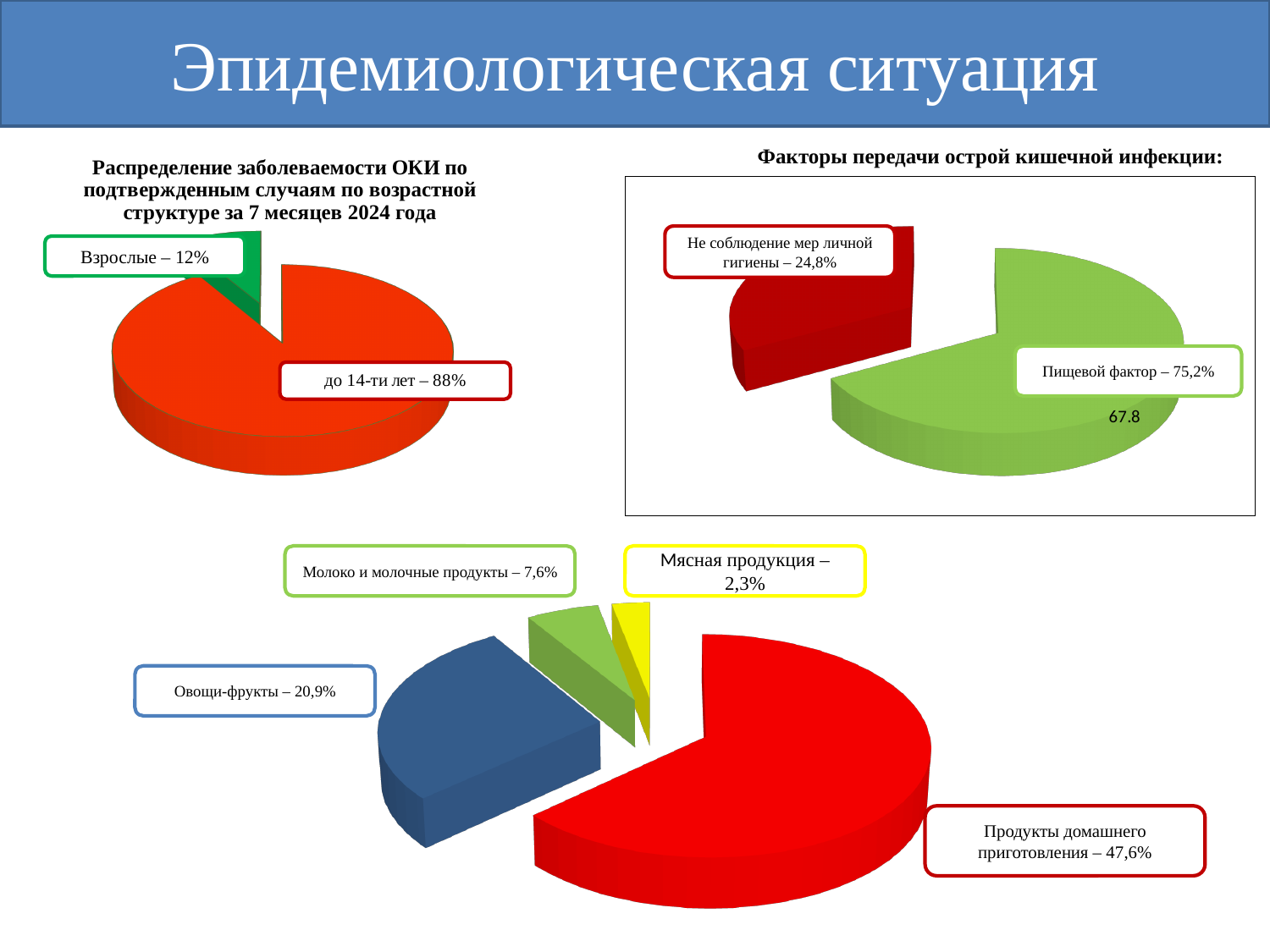
In the bottom pie chart, what share is labelled for 'Продукты домашнего приготовления'? 47,6% In the top-left pie chart on age structure, which category has the largest slice? до 14-ти лет In the top-left pie chart on age structure, what share is labelled for 'Взрослые'? 12% In the bottom pie chart, which is larger: 'Молоко и молочные продукты' or 'Мясная продукция'? Молоко и молочные продукты In the top-right chart 'Факторы передачи острой кишечной инфекции', what share is labelled for 'Не соблюдение мер личной гигиены'? 24,8% In the top-left pie chart on age structure, what share is labelled for 'до 14-ти лет'? 88% In the top-right chart 'Факторы передачи острой кишечной инфекции', what share is labelled for 'Пищевой фактор'? 75,2% In the bottom pie chart, what share is labelled for 'Мясная продукция'? 2,3% In the bottom pie chart, what share is labelled for 'Овощи-фрукты'? 20,9% In the top-right chart 'Факторы передачи острой кишечной инфекции', which factor has the smaller slice? Не соблюдение мер личной гигиены What kind of chart is used for the top-left age structure chart? Pie chart In the top-left pie chart on age structure, what is the difference between the shares for 'до 14-ти лет' and 'Взрослые'? 76%